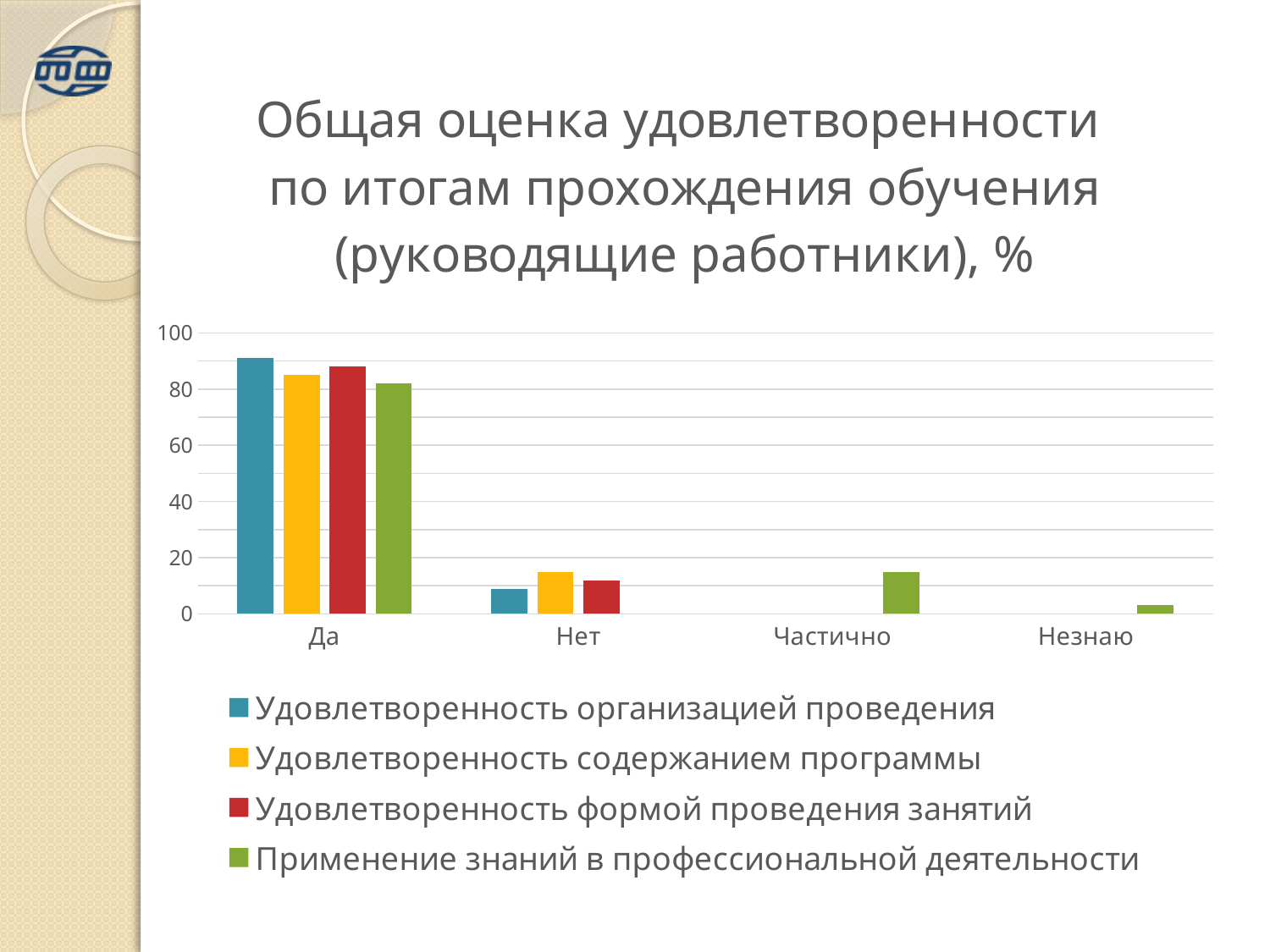
How many categories are shown on the x axis of the chart? 4 What kind of chart is shown on the slide? bar chart How many series does the legend list? 4 Which category has the highest value for the series "Применение знаний в профессиональной деятельности"? Да Is the value for "Незнаю" in the series "Применение знаний в профессиональной деятельности" greater or less than 20? less Is the value for "Нет" in the series "Удовлетворенность содержанием программы" greater or less than 20? less For the category "Да", which is larger: the value for "Удовлетворенность организацией проведения" or the value for "Применение знаний в профессиональной деятельности"? Удовлетворенность организацией проведения Which category has the lowest value for the series "Применение знаний в профессиональной деятельности"? Незнаю Which series is shown in green in the legend? Применение знаний в профессиональной деятельности Is the value for "Да" in the series "Удовлетворенность организацией проведения" greater or less than 80? greater Which category has the highest value for the series "Удовлетворенность организацией проведения"? Да Which category on the x axis has a bar only for the series "Применение знаний в профессиональной деятельности" and no bars for the other series? Частично and Незнаю